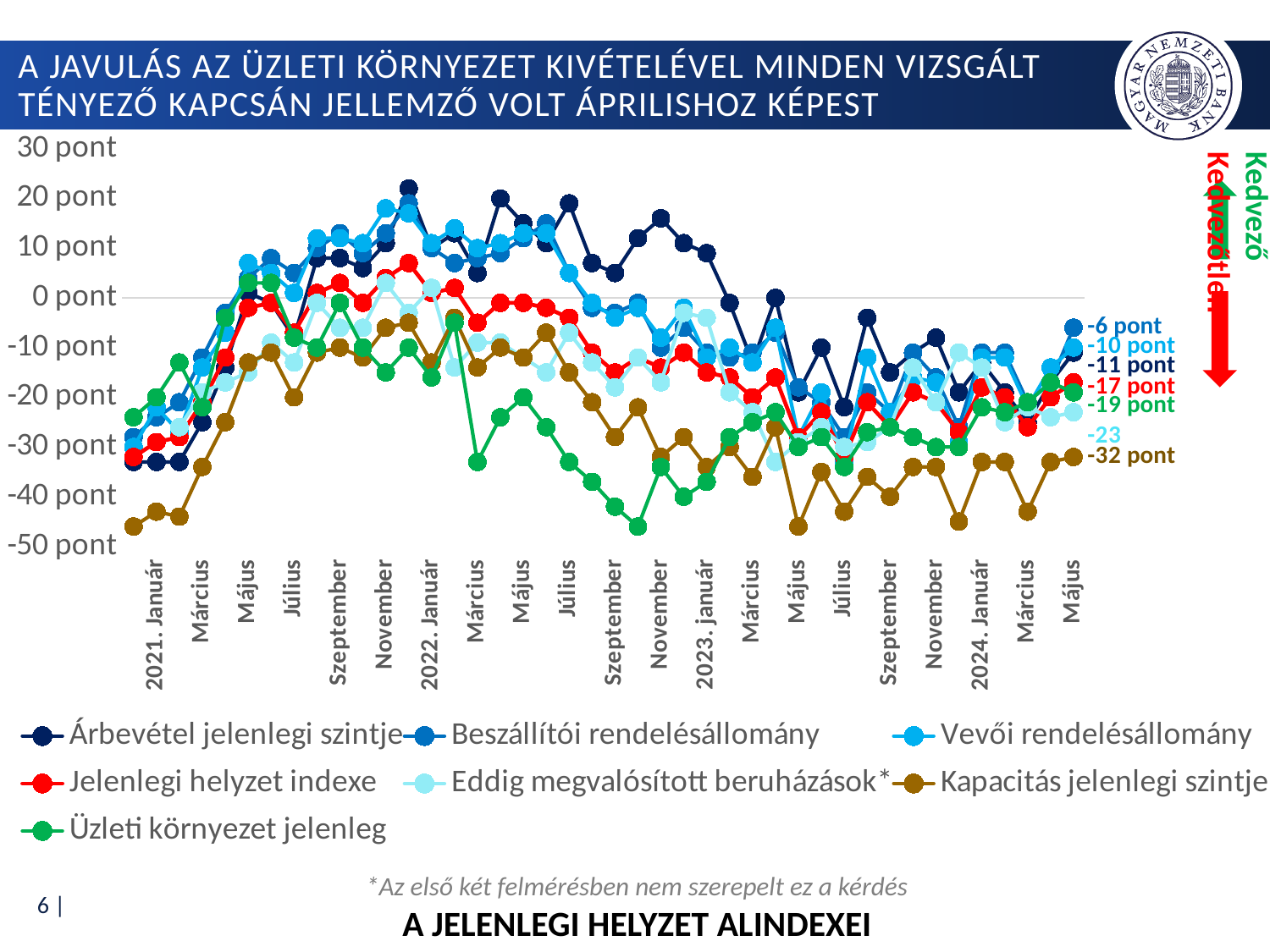
Is the value for Kapacitás jelenlegi szintje in 2021. Január greater or less than -40 pont? less What is the latest value labelled for Kapacitás jelenlegi szintje? -32 pont What kind of chart is shown on the slide? line chart At the end of the chart, which is larger: the value for Vevői rendelésállomány or the value for Jelenlegi helyzet indexe? Vevői rendelésállomány What is the difference between the latest values of Beszállítói rendelésállomány (-6 pont) and Kapacitás jelenlegi szintje (-32 pont)? 26 pont What is the latest value labelled for Árbevétel jelenlegi szintje? -11 pont Which series has the highest value at the end of the chart (May 2024)? Beszállítói rendelésállomány What is the latest (May 2024) value labelled for Beszállítói rendelésállomány? -6 pont How many series does the legend list? 7 What is the latest value labelled for Jelenlegi helyzet indexe? -17 pont Which series has the lowest value at the end of the chart (May 2024)? Kapacitás jelenlegi szintje What is the latest value labelled for Üzleti környezet jelenleg? -19 pont